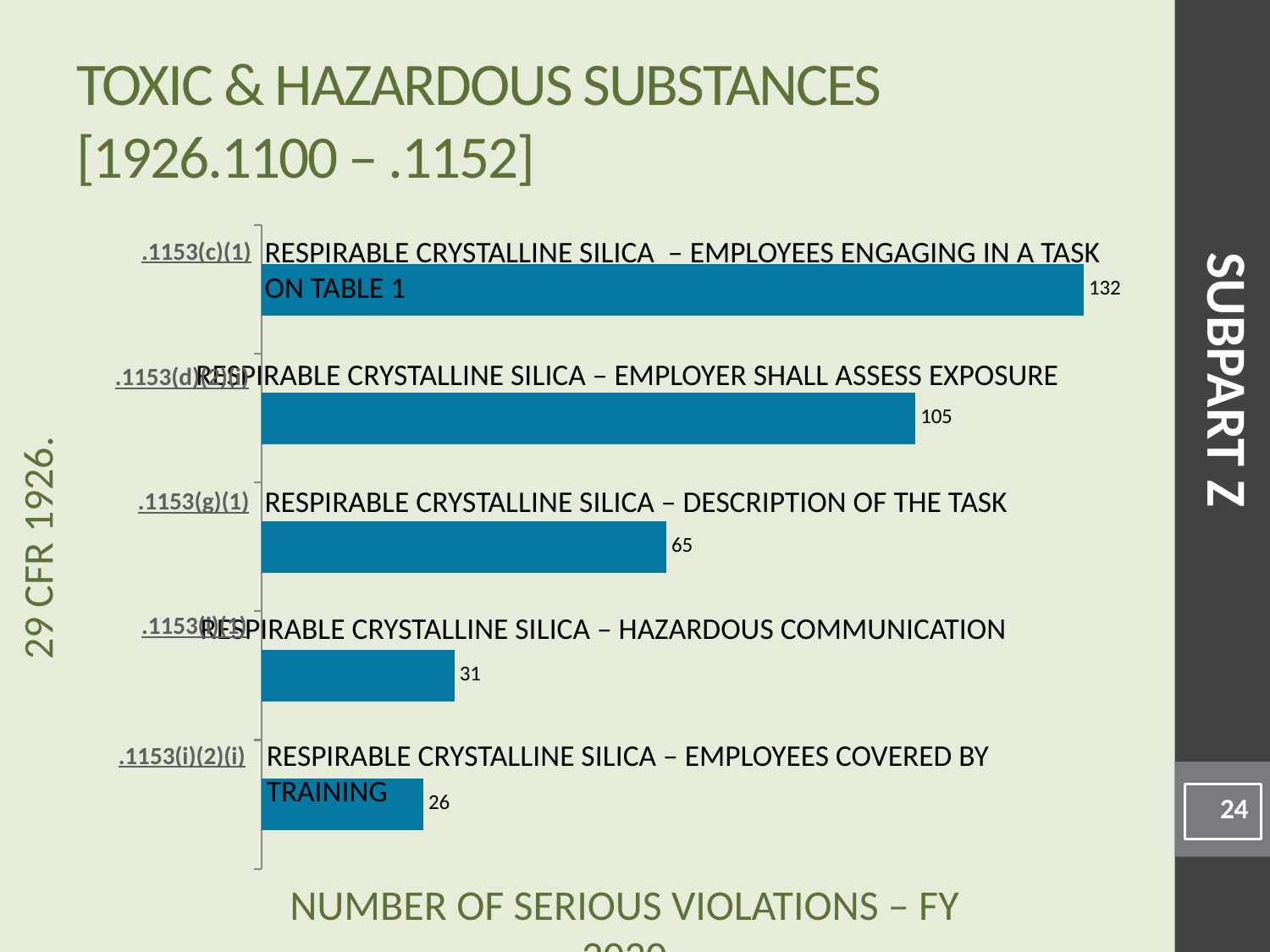
What is the difference between the 'Employer Shall Assess Exposure' bar and the 'Hazardous Communication' bar? 74 Which has more serious violations, .1153(g)(1) or .1153(i)(2)(i)? .1153(g)(1) Which standard has the highest number of serious violations? .1153(c)(1) What type of chart is shown on the slide? Bar chart What is the number of serious violations for .1153(g)(1)? 65 What is the value shown for the bar labelled 'Respirable Crystalline Silica – Employer Shall Assess Exposure'? 105 What is the number of serious violations for .1153(i)(2)(i)? 26 What is the value shown for the bar labelled 'Respirable Crystalline Silica – Hazardous Communication'? 31 Which standard has the lowest number of serious violations? .1153(i)(2)(i) How many bars are shown in the chart? 5 What is the difference between the values for .1153(c)(1) and .1153(g)(1)? 67 What is the number of serious violations for .1153(c)(1)? 132